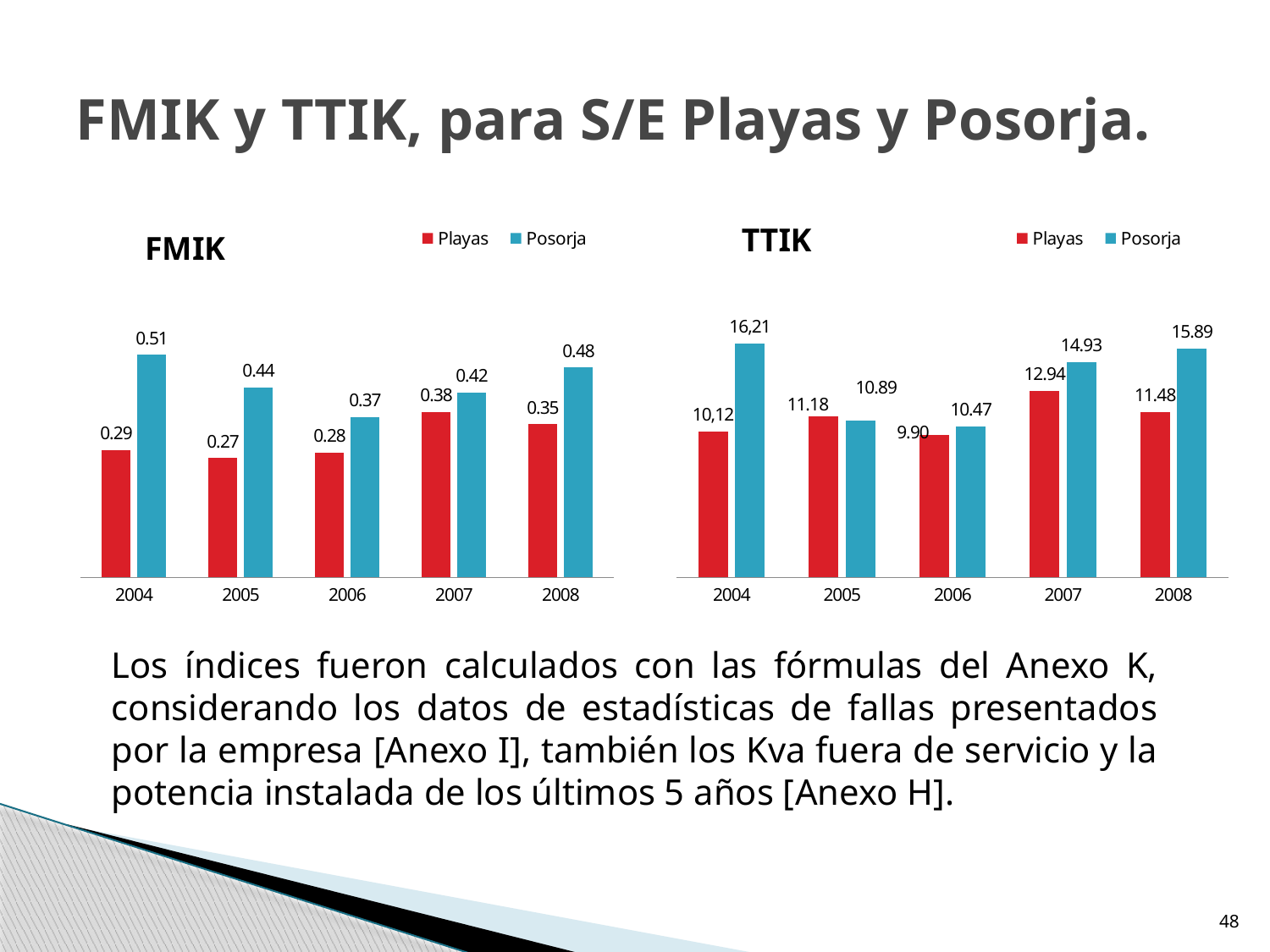
In the FMIK chart, which year has the lowest value for Playas? 2005 In the TTIK chart, what is the value for Playas in 2006? 9.90 In the TTIK chart, which year has the highest value for Posorja? 2004 In the FMIK chart, what is the value for Playas in 2007? 0.38 In the FMIK chart, what is the value for Posorja in 2004? 0.51 How many series does the legend of the TTIK chart list? 2 In the TTIK chart, which is larger in 2005, Playas or Posorja? Playas In the FMIK chart, what is the difference between the Posorja and Playas values in 2008? 0.13 What kind of chart is the FMIK chart? Bar chart In the TTIK chart, what is the value for Posorja in 2008? 15.89 In the TTIK chart, what is the difference between the Playas and Posorja values in 2005? 0.29 How many years are shown on the x axis of the FMIK chart? 5